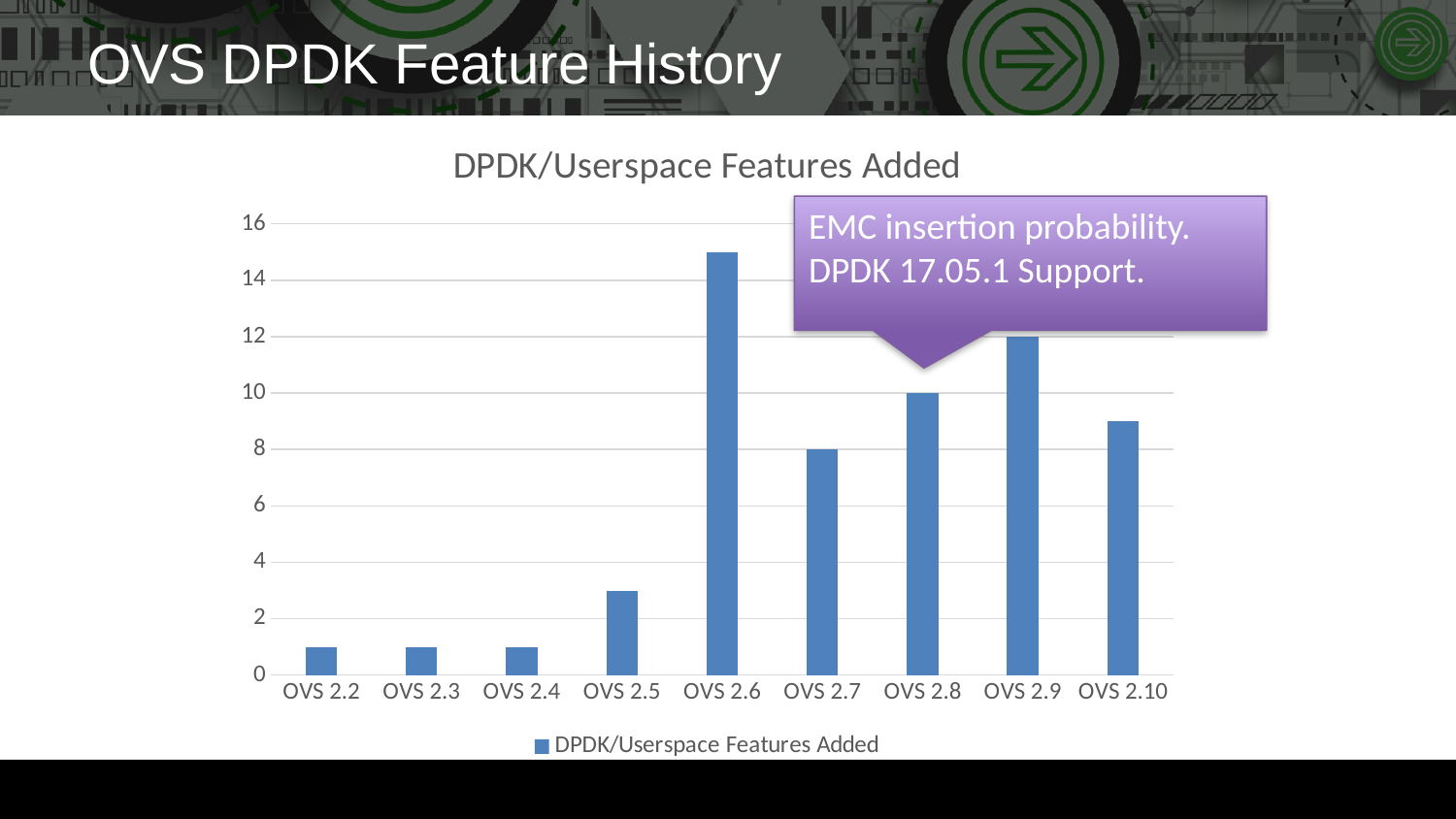
Which has more DPDK/Userspace features added, OVS 2.6 or OVS 2.9? OVS 2.6 What is the title of the chart? DPDK/Userspace Features Added Is the value for OVS 2.10 greater or less than 10? less What is the difference between the number of features added in OVS 2.9 and in OVS 2.7? 4 How many OVS versions are shown on the x axis of the chart? 9 How many DPDK/Userspace features were added in OVS 2.9? 12 Is the value for OVS 2.6 greater or less than 14? greater How many series does the chart's legend list? 1 What kind of chart is shown on the slide? Bar chart How many DPDK/Userspace features were added in OVS 2.8? 10 Which OVS version has the highest number of DPDK/Userspace features added? OVS 2.6 How many DPDK/Userspace features were added in OVS 2.7? 8